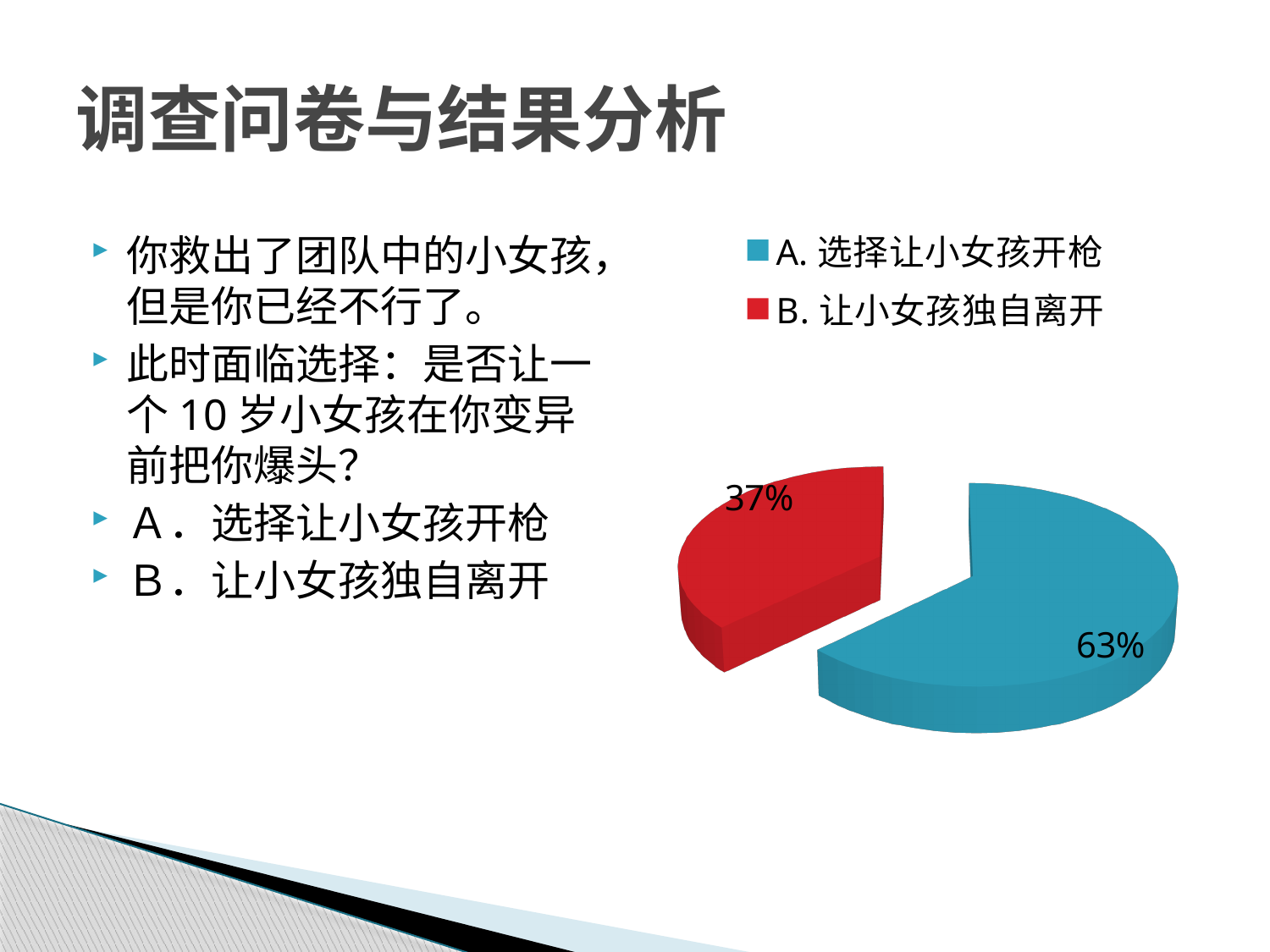
Which option has the largest slice of the pie? A. 选择让小女孩开枪 How many entries does the legend list? 2 What colour is the slice for "A. 选择让小女孩开枪"? blue Which is larger, the slice for "A. 选择让小女孩开枪" or the slice for "B. 让小女孩独自离开"? A. 选择让小女孩开枪 What is the difference in percentage points between the slice for A and the slice for B? 26 What colour is the slice for "B. 让小女孩独自离开"? red What share of the pie does "A. 选择让小女孩开枪" take? 63% What kind of chart is shown on the slide? pie chart How many slices does the pie chart have? 2 What share of the pie does "B. 让小女孩独自离开" take? 37% Which option has the smallest slice of the pie? B. 让小女孩独自离开